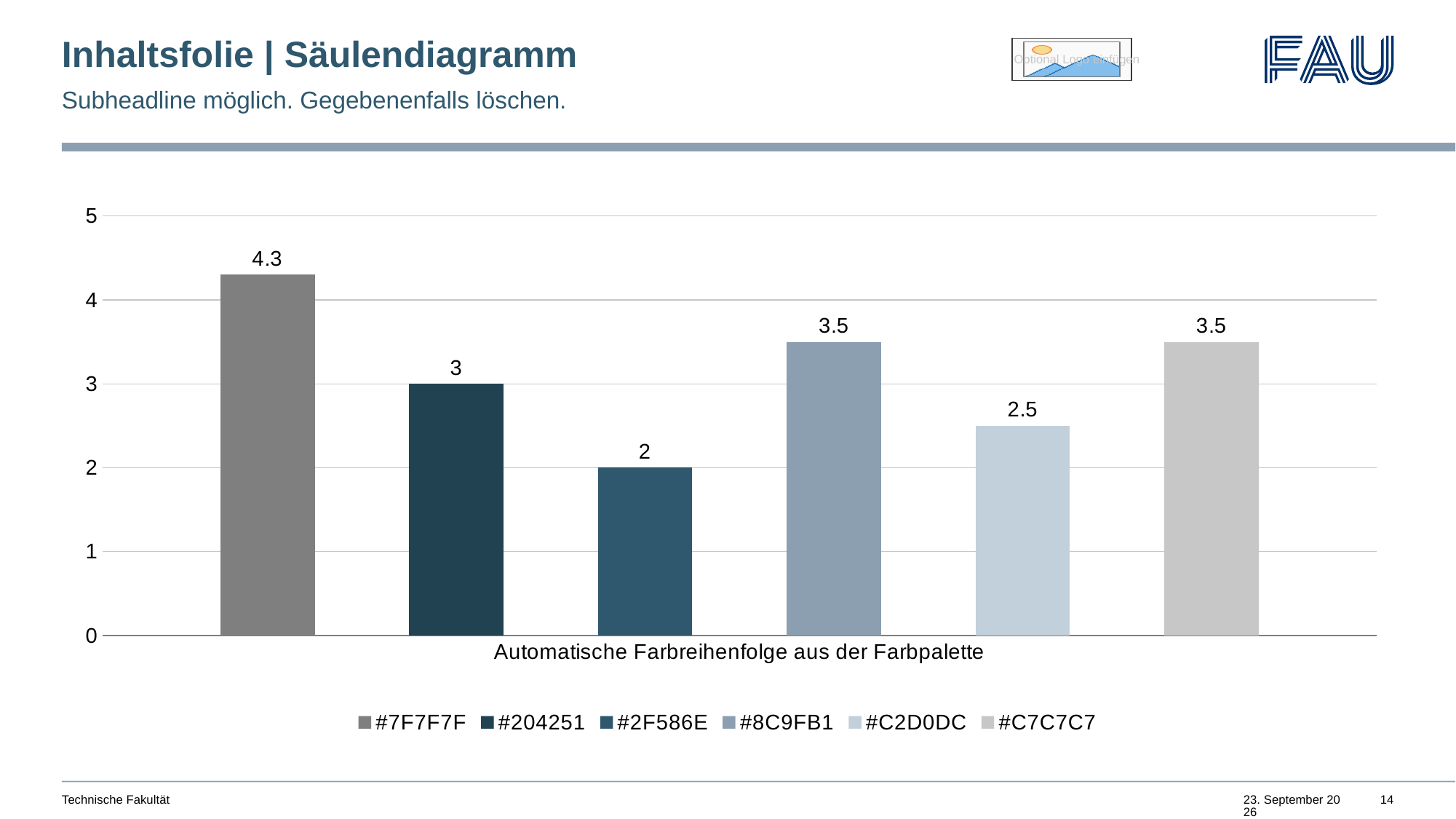
Which is larger, the value for #204251 or the value for #C2D0DC? #204251 What is the difference between the values for #8C9FB1 and #C2D0DC? 1 What kind of chart is shown on the slide? bar chart What is the value for the #7F7F7F series? 4.3 How many series does the legend list? 6 What is the difference between the values for #7F7F7F and #2F586E? 2.3 What is the value for the #204251 series? 3 What is the value for the #C2D0DC series? 2.5 Which series has the lowest value? #2F586E What is the value for the #2F586E series? 2 What is the category label shown on the x axis? Automatische Farbreihenfolge aus der Farbpalette Which series has the highest value? #7F7F7F